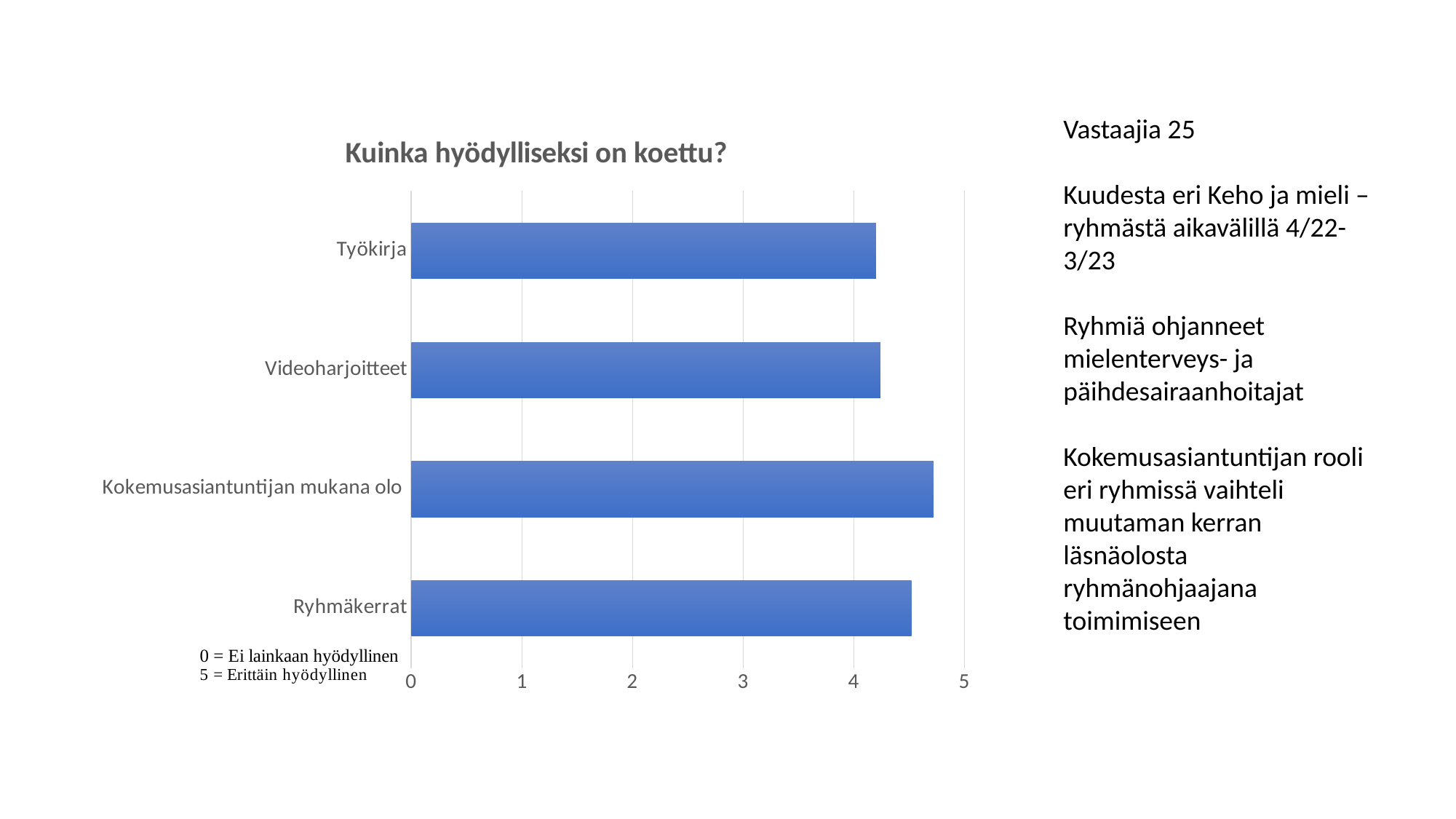
Is the value for Työkirja greater or less than 4? greater Which is larger, the value for Ryhmäkerrat or the value for Työkirja? Ryhmäkerrat Is the value for Ryhmäkerrat greater or less than 4? greater Which category has the highest value in the chart? Kokemusasiantuntijan mukana olo What is the title of the chart? Kuinka hyödylliseksi on koettu? Is the value for Kokemusasiantuntijan mukana olo greater or less than 5? less What kind of chart is shown on the slide? bar chart Which is larger, the value for Kokemusasiantuntijan mukana olo or the value for Videoharjoitteet? Kokemusasiantuntijan mukana olo How many categories are shown in the chart? 4 What is the maximum value shown on the horizontal axis of the chart? 5